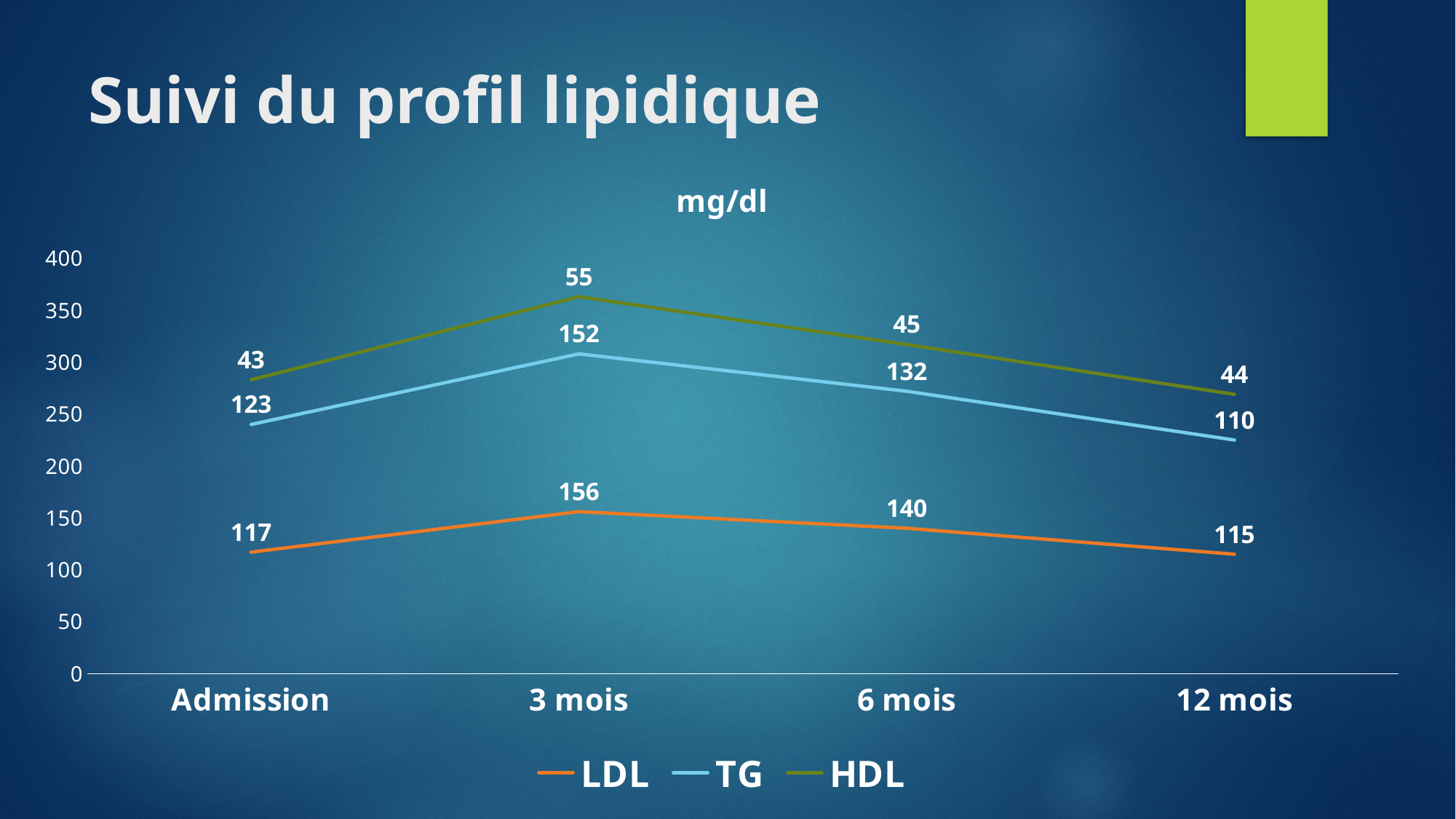
How many series does the legend list? 3 What is the difference between the LDL value at 3 mois and at 12 mois? 41 What kind of chart is shown on the slide? Line chart What is the LDL value at 12 mois? 115 How many time points are shown on the x axis? 4 What is the TG value at 3 mois? 152 At which time point is the TG value lowest? 12 mois What is the HDL value at 6 mois? 45 Which is larger, the TG value at Admission or the TG value at 6 mois? 6 mois What is the title of the slide? Suivi du profil lipidique What is the LDL value at Admission? 117 At which time point is the LDL value highest? 3 mois